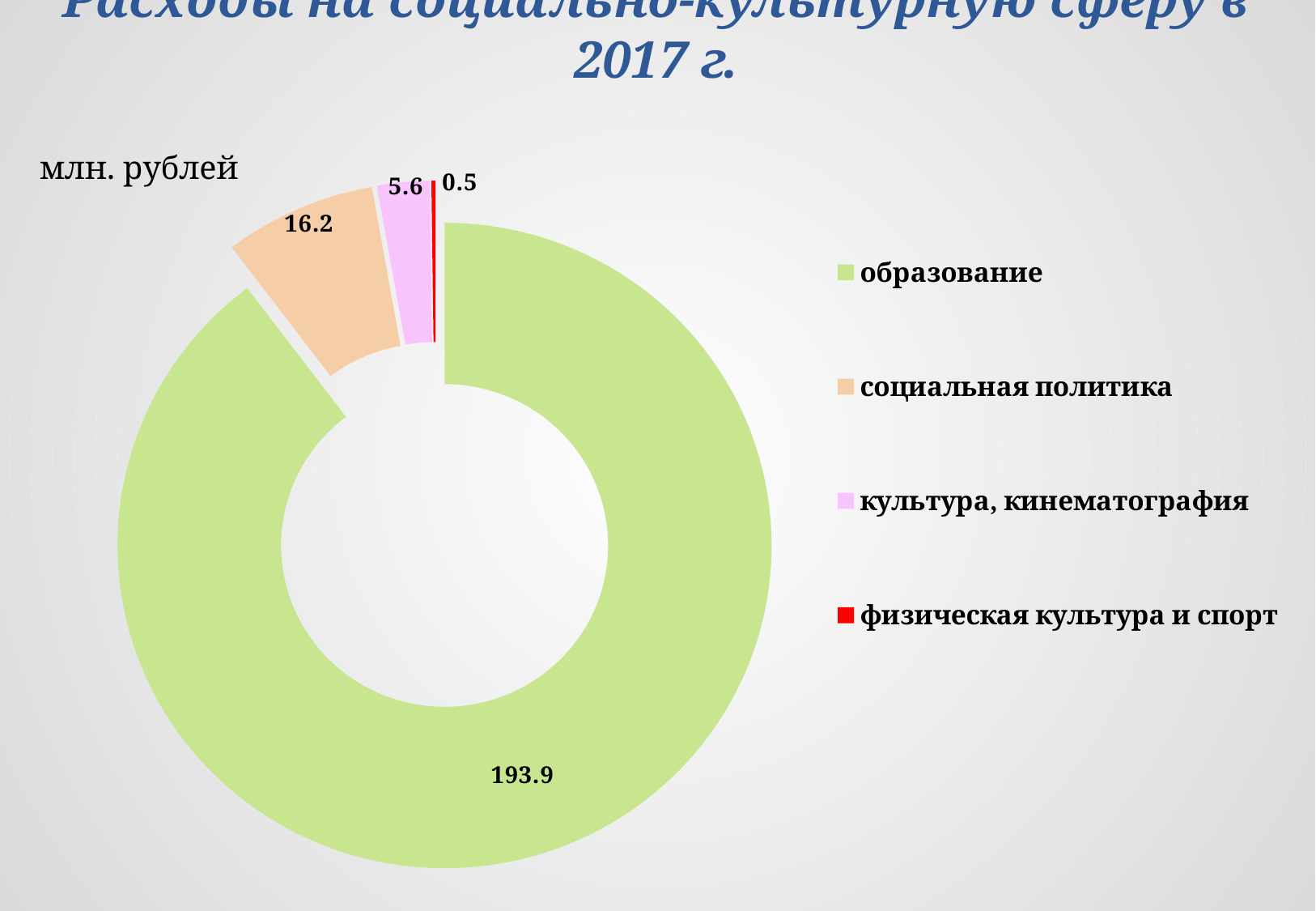
What kind of chart is shown on the slide? doughnut chart What is the value for физическая культура и спорт? 0.5 Which category has the highest value? образование What is the total of all the values shown in the chart? 216.2 What is the value for социальная политика? 16.2 What is the value for образование? 193.9 What is the difference between the values for социальная политика and культура, кинематография? 10.6 Which is larger, the value for социальная политика or the value for культура, кинематография? социальная политика What unit of measurement is indicated for the chart values? млн. рублей What is the value for культура, кинематография? 5.6 How many categories are shown in the chart? 4 Which category has the lowest value? физическая культура и спорт